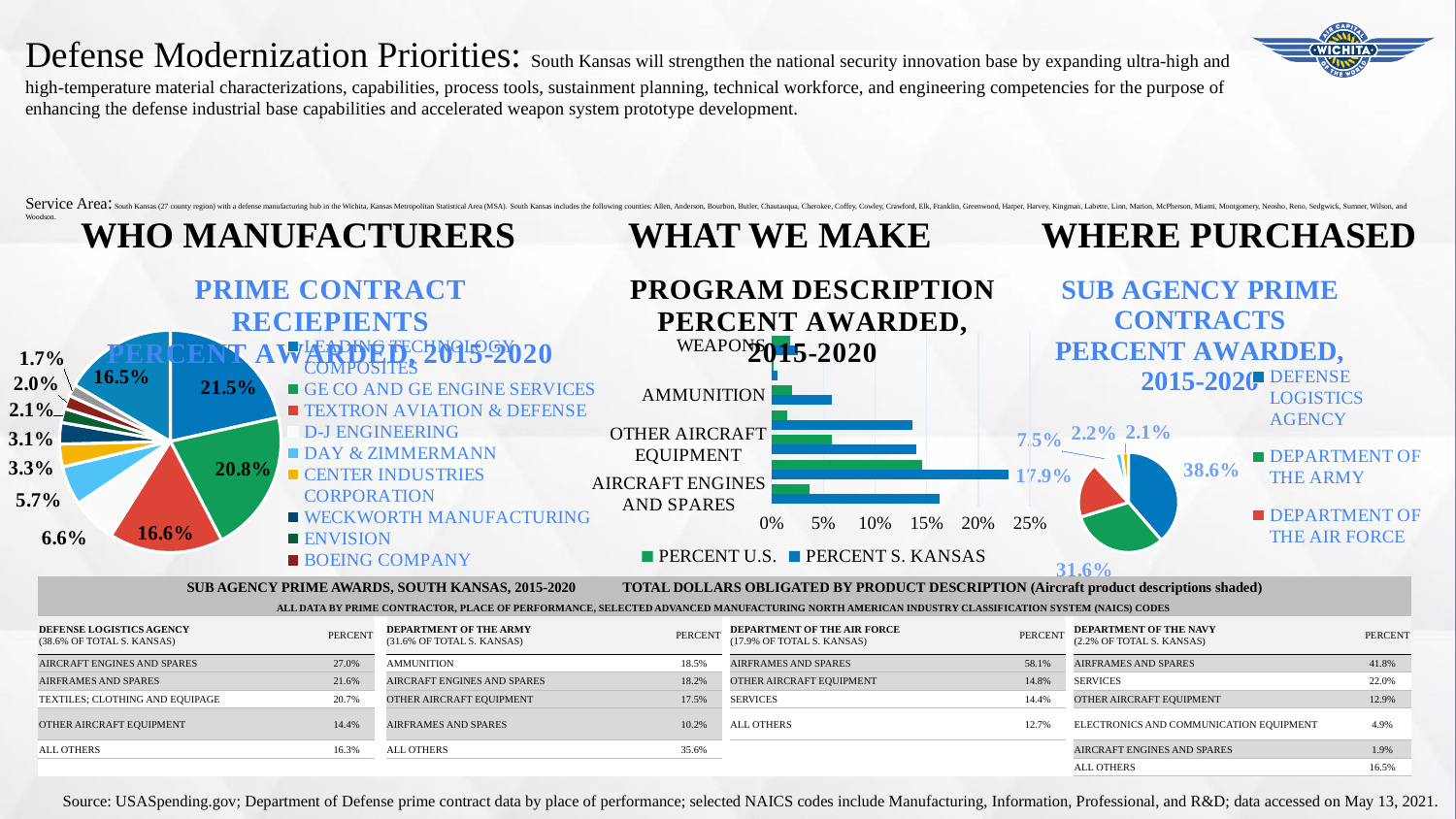
In the 'PRIME CONTRACT RECIPIENTS PERCENT AWARDED, 2015-2020' pie chart, what is the difference between the 21.5% slice and the 20.8% slice? 0.7% In the 'PROGRAM DESCRIPTION PERCENT AWARDED, 2015-2020' chart, is the Percent S. Kansas value for Ammunition greater or less than 10%? less In the 'SUB AGENCY PRIME CONTRACTS PERCENT AWARDED, 2015-2020' pie chart, what is the difference between the Defense Logistics Agency share (38.6%) and the Department of the Army share (31.6%)? 7.0% How many slices does the 'PRIME CONTRACT RECIPIENTS PERCENT AWARDED, 2015-2020' pie chart have? 11 What kind of chart is the 'PRIME CONTRACT RECIPIENTS PERCENT AWARDED, 2015-2020' chart? Pie chart In the 'PRIME CONTRACT RECIPIENTS PERCENT AWARDED, 2015-2020' pie chart, what is the largest slice's value? 21.5% In the 'PRIME CONTRACT RECIPIENTS PERCENT AWARDED, 2015-2020' pie chart, what is the smallest labelled slice's value? 1.7% What kind of chart is the 'SUB AGENCY PRIME CONTRACTS PERCENT AWARDED, 2015-2020' chart? Pie chart In the 'SUB AGENCY PRIME CONTRACTS PERCENT AWARDED, 2015-2020' pie chart, which sub agency has the largest share? Defense Logistics Agency In the 'SUB AGENCY PRIME CONTRACTS PERCENT AWARDED, 2015-2020' pie chart, what share does the Defense Logistics Agency have? 38.6% What kind of chart is the 'PROGRAM DESCRIPTION PERCENT AWARDED, 2015-2020' chart? Bar chart How many series does the legend of the 'PROGRAM DESCRIPTION PERCENT AWARDED, 2015-2020' chart list? 2